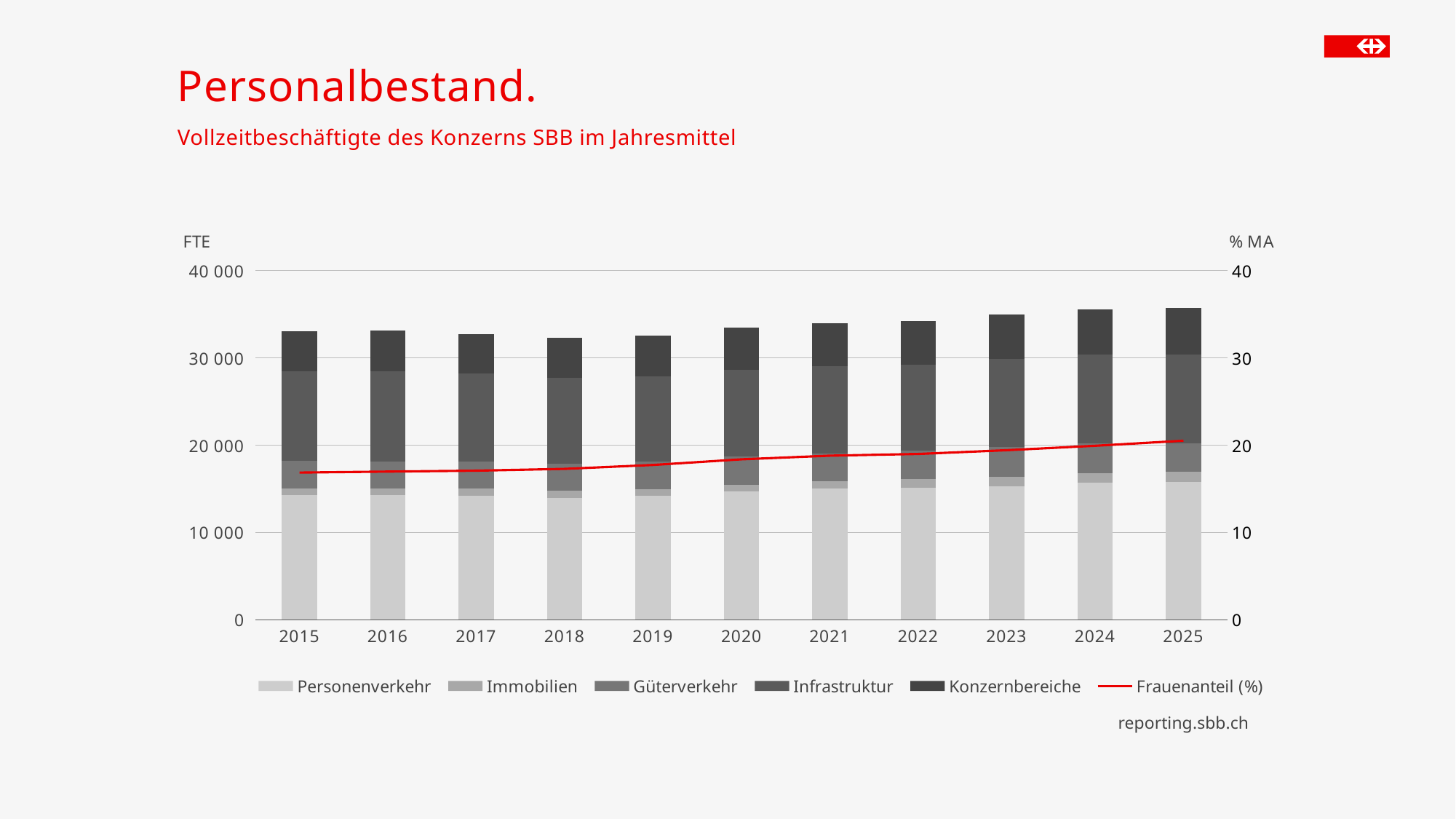
Is the Personenverkehr value for 2015 greater or less than 10 000? greater What kind of chart is shown on the slide? A stacked bar chart with a line Is the total FTE value for 2025 greater or less than 30 000? greater What label is shown on the left vertical axis of the chart? FTE Which year has the larger total FTE bar, 2018 or 2025? 2025 What is the title of the slide? Personalbestand. How many series does the legend list? 6 Is the Frauenanteil (%) value for 2015 greater or less than 20? less Does the Frauenanteil (%) line rise or fall from 2015 to 2025? It rises How many years are shown on the x axis of the chart? 11